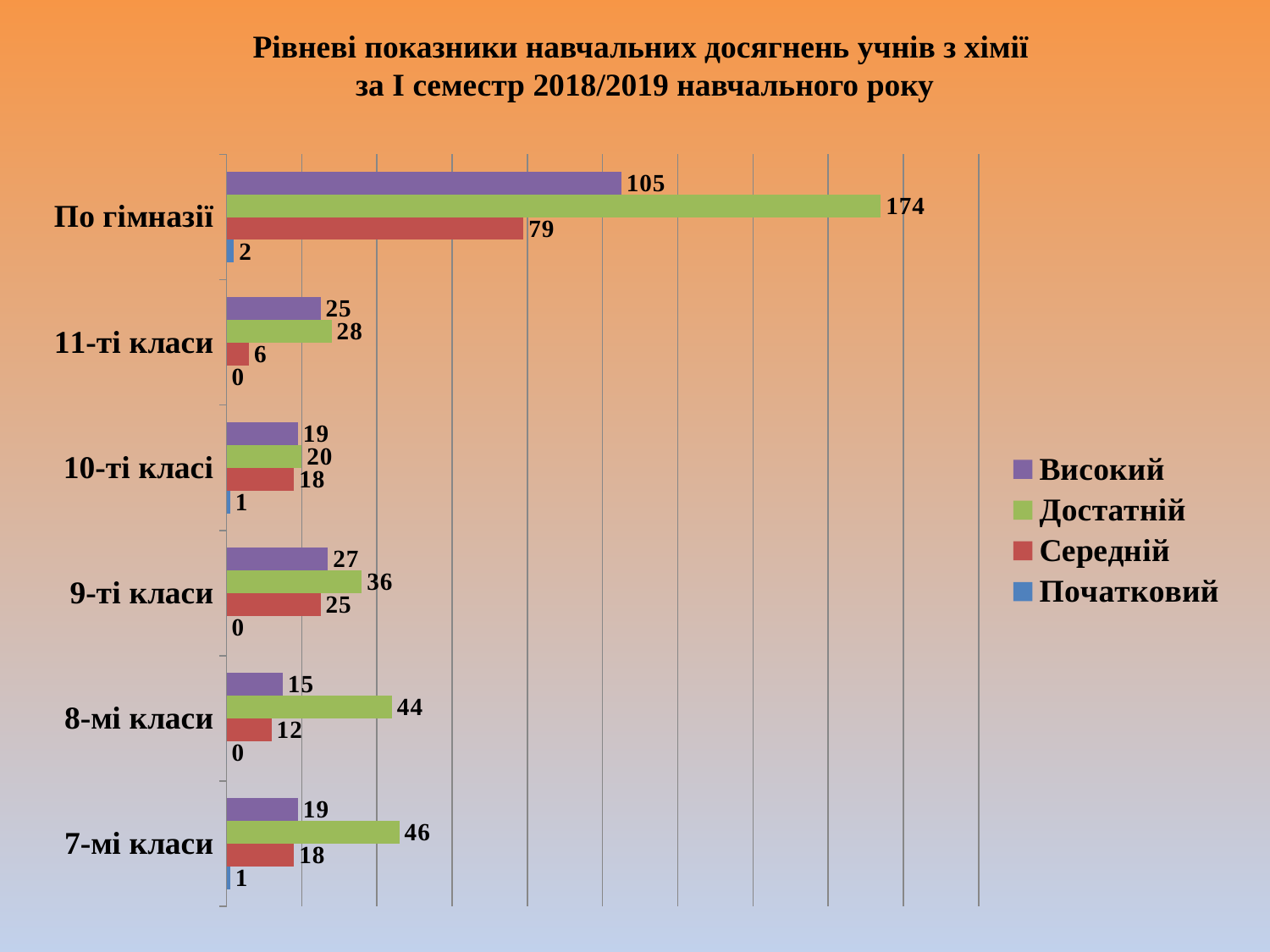
What is the difference between the Достатній and Високий values for По гімназії? 69 Which category has the lowest Середній value? 11-ті класи What is the value for Середній for 8-мі класи? 12 Which legend entry is shown in green? Достатній What is the value for Високий for 11-ті класи? 25 What is the value for Достатній for По гімназії? 174 Which is larger for 9-ті класи: Високий or Середній? Високий What is the value for Початковий for 10-ті класі? 1 How many series does the legend list? 4 How many categories are shown on the y axis? 6 What kind of chart is shown on the slide? Bar chart Which class category has the highest Достатній value (excluding По гімназії)? 7-мі класи